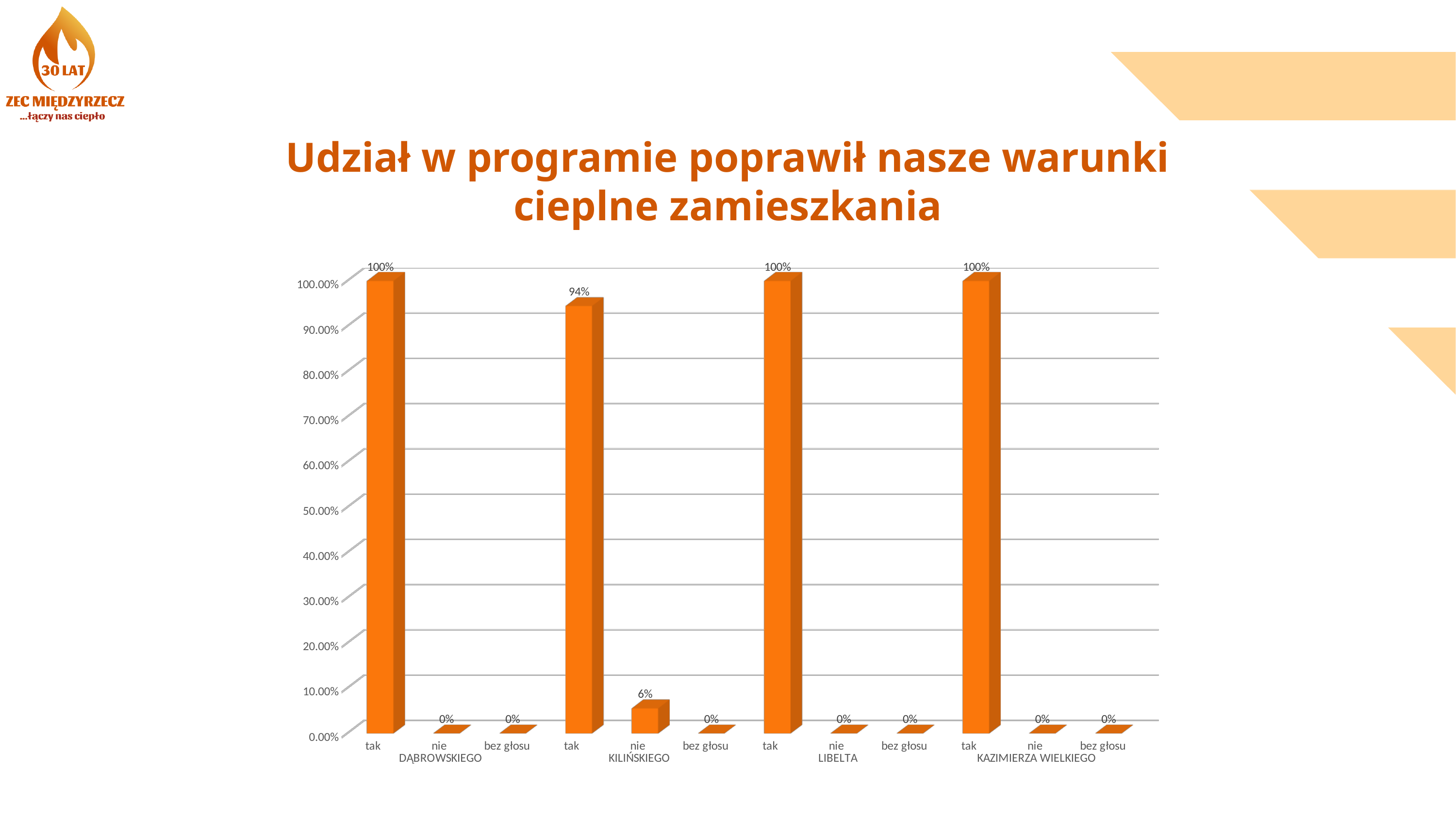
What kind of chart is shown on the slide? bar chart What is the value for "tak" in the DĄBROWSKIEGO group? 100% What is the difference between the "tak" and "nie" values in the KILIŃSKIEGO group? 88% What is the value for "tak" in the KILIŃSKIEGO group? 94% How many street groups are shown on the x axis? 4 Which street group has the lowest value for "tak"? KILIŃSKIEGO What is the value for "nie" in the KAZIMIERZA WIELKIEGO group? 0% What is the title of the chart? Udział w programie poprawił nasze warunki cieplne zamieszkania Which is larger: the "tak" value for LIBELTA or the "tak" value for KILIŃSKIEGO? LIBELTA What is the value for "nie" in the KILIŃSKIEGO group? 6% What is the value for "bez głosu" in the LIBELTA group? 0% Is the value for "nie" in the KILIŃSKIEGO group greater or less than 10.00%? less